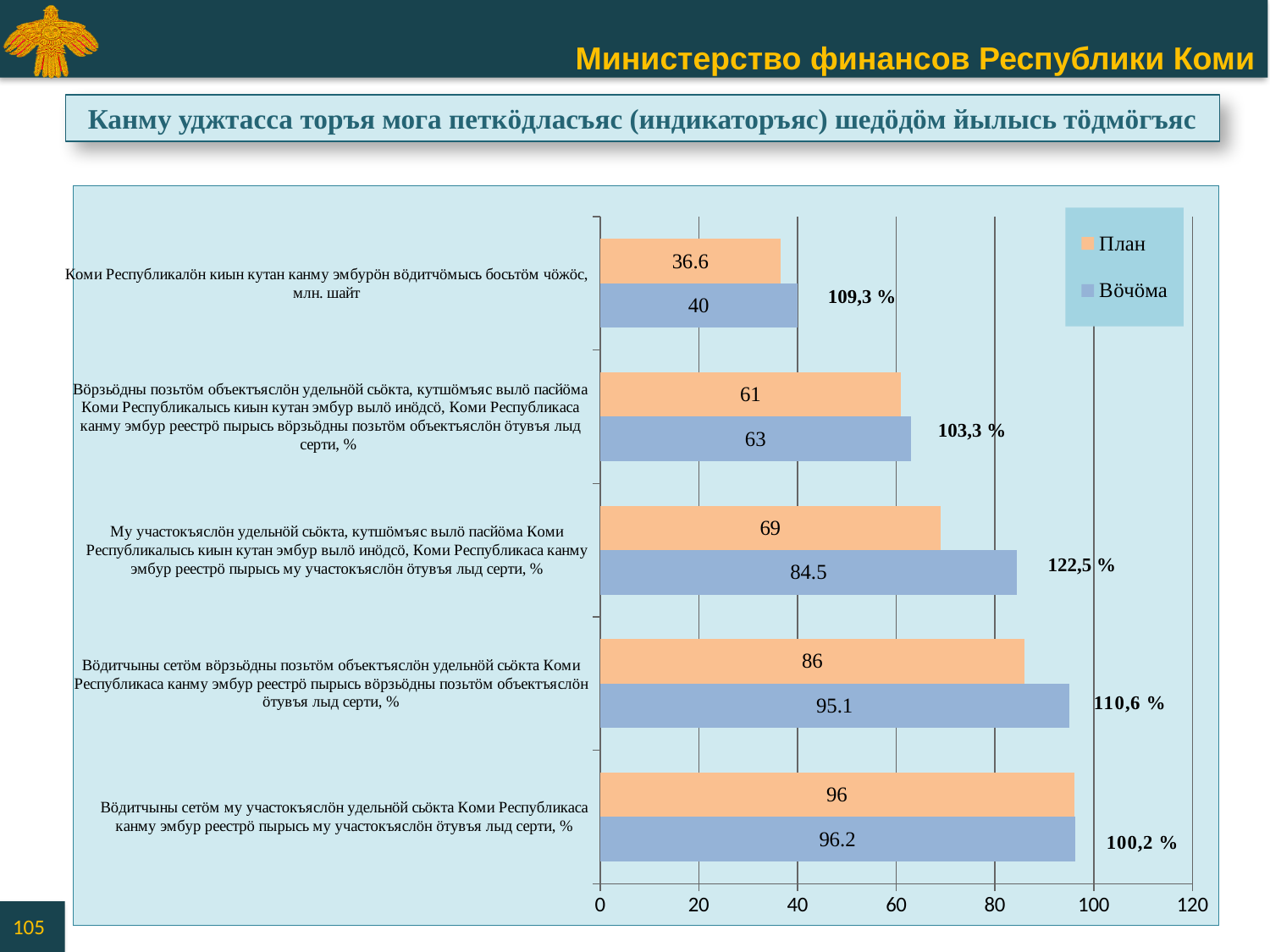
How many series does the chart legend list? 2 What is the Вöчöма value for the bottom category (Вöдитчыны сетöм му участокъяслöн удельнöй сьöкта...)? 96.2 What is the План value for the third category from the top (Му участокъяслöн удельнöй сьöкта...)? 69 How many categories (indicators) are plotted on the chart? 5 What percentage label is printed next to the bars of the third category from the top (Му участокъяслöн удельнöй сьöкта...)? 122,5 % Which category has the lowest Вöчöма value? Коми Республикалöн киын кутан канму эмбурöн вöдитчöмысь босьтöм чöжöс, млн. шайт What kind of chart is shown on the slide? bar chart For the third category from the top (Му участокъяслöн удельнöй сьöкта...), what is the difference between the Вöчöма value and the План value? 15.5 What is the Вöчöма value for the top category, the one measured in млн. шайт? 40 What is the План value for the top category, the one measured in млн. шайт? 36.6 For the third category from the top (Му участокъяслöн удельнöй сьöкта...), which is larger, План or Вöчöма? Вöчöма Is the Вöчöма value for the fourth category from the top (Вöдитчыны сетöм вöрзьöдны позьтöм объектъяслöн...) greater or less than 80? greater